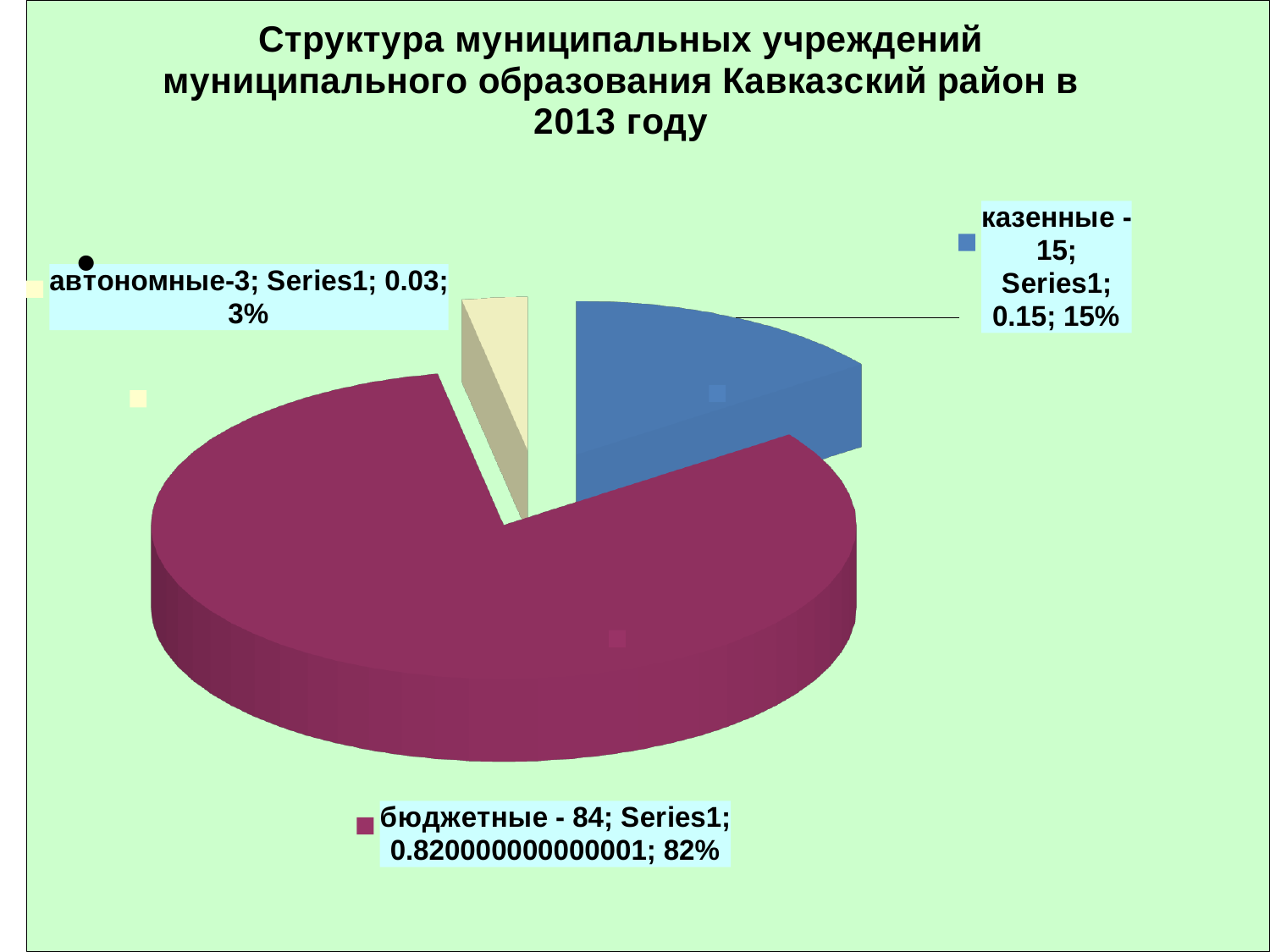
What value is printed in the data label for 'автономные-3'? 0.03 Which slice of the pie chart is the smallest? автономные-3 What percentage share does the slice 'бюджетные - 84' have? 82% What percentage share does the slice 'автономные-3' have? 3% What is the difference in percentage points between the 'казенные - 15' share and the 'автономные-3' share? 12% What series name appears in the data labels of the pie chart? Series1 What percentage share does the slice 'казенные - 15' have? 15% What value is printed in the data label for 'казенные - 15'? 0.15 Which slice is larger: 'казенные - 15' or 'автономные-3'? казенные - 15 Which slice of the pie chart is the largest? бюджетные - 84 How many slices does the pie chart have? 3 What kind of chart is shown on the slide? pie chart